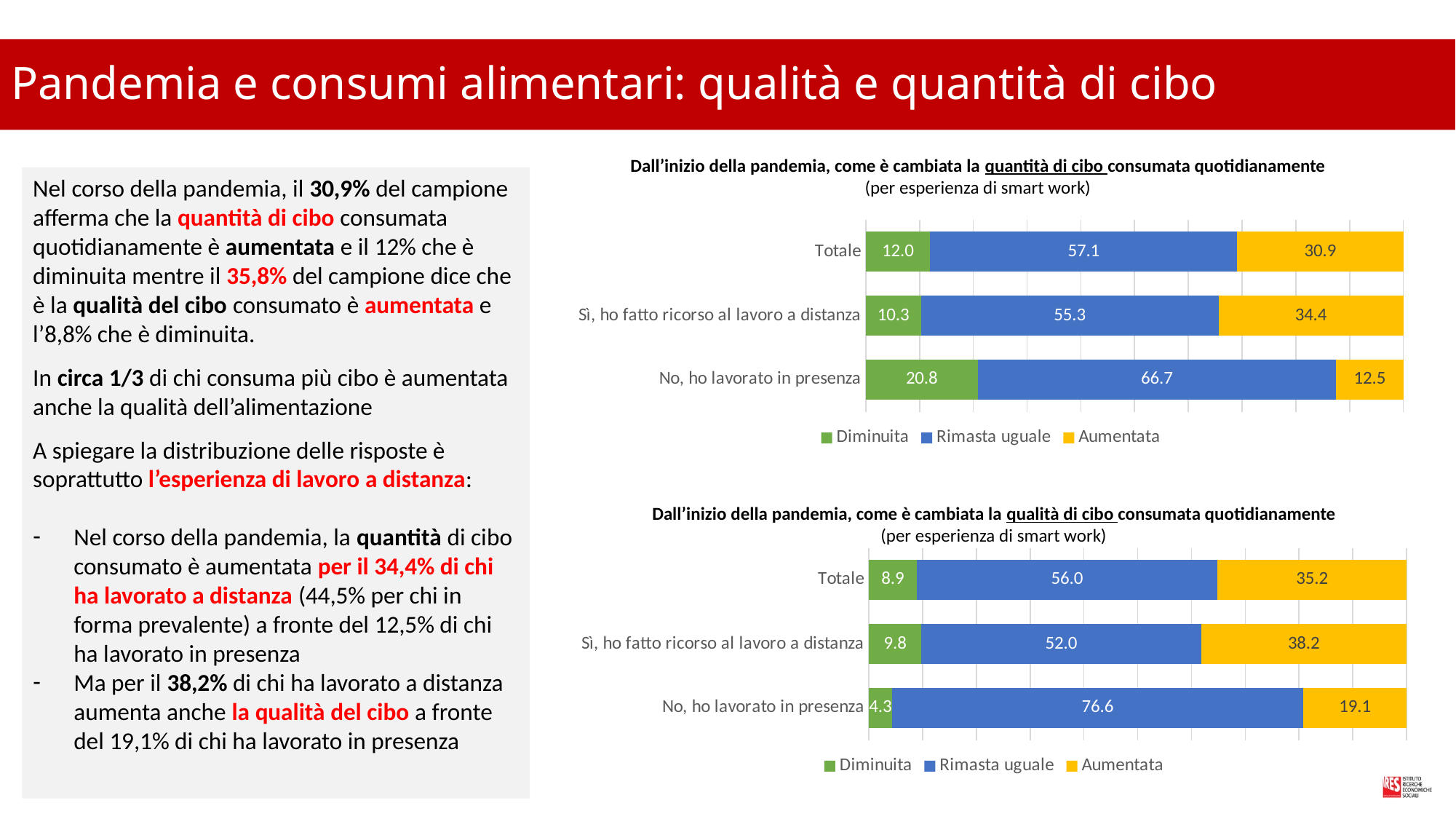
In the top chart (quantità di cibo), what is the difference between the 'Aumentata' values for 'Sì, ho fatto ricorso al lavoro a distanza' and 'No, ho lavorato in presenza'? 21.9 In the bottom chart (qualità di cibo), which colour represents 'Rimasta uguale'? Blue How many series does the legend of the bottom chart (qualità di cibo) list? 3 In the bottom chart (qualità di cibo), what is the value of 'Aumentata' for 'No, ho lavorato in presenza'? 19.1 In the bottom chart (qualità di cibo), which is larger: 'Aumentata' for 'Totale' or 'Aumentata' for 'Sì, ho fatto ricorso al lavoro a distanza'? Sì, ho fatto ricorso al lavoro a distanza In the bottom chart (qualità di cibo), what is the value of 'Diminuita' for 'Totale'? 8.9 What type of chart is the top chart (quantità di cibo)? Stacked bar chart In the top chart (quantità di cibo), what is the value of 'Rimasta uguale' for 'No, ho lavorato in presenza'? 66.7 In the top chart (quantità di cibo), what is the value of 'Aumentata' for 'Sì, ho fatto ricorso al lavoro a distanza'? 34.4 In the top chart (quantità di cibo), which category has the highest 'Diminuita' value? No, ho lavorato in presenza How many categories are shown in the top chart (quantità di cibo)? 3 In the bottom chart (qualità di cibo), which category has the lowest 'Rimasta uguale' value? Sì, ho fatto ricorso al lavoro a distanza